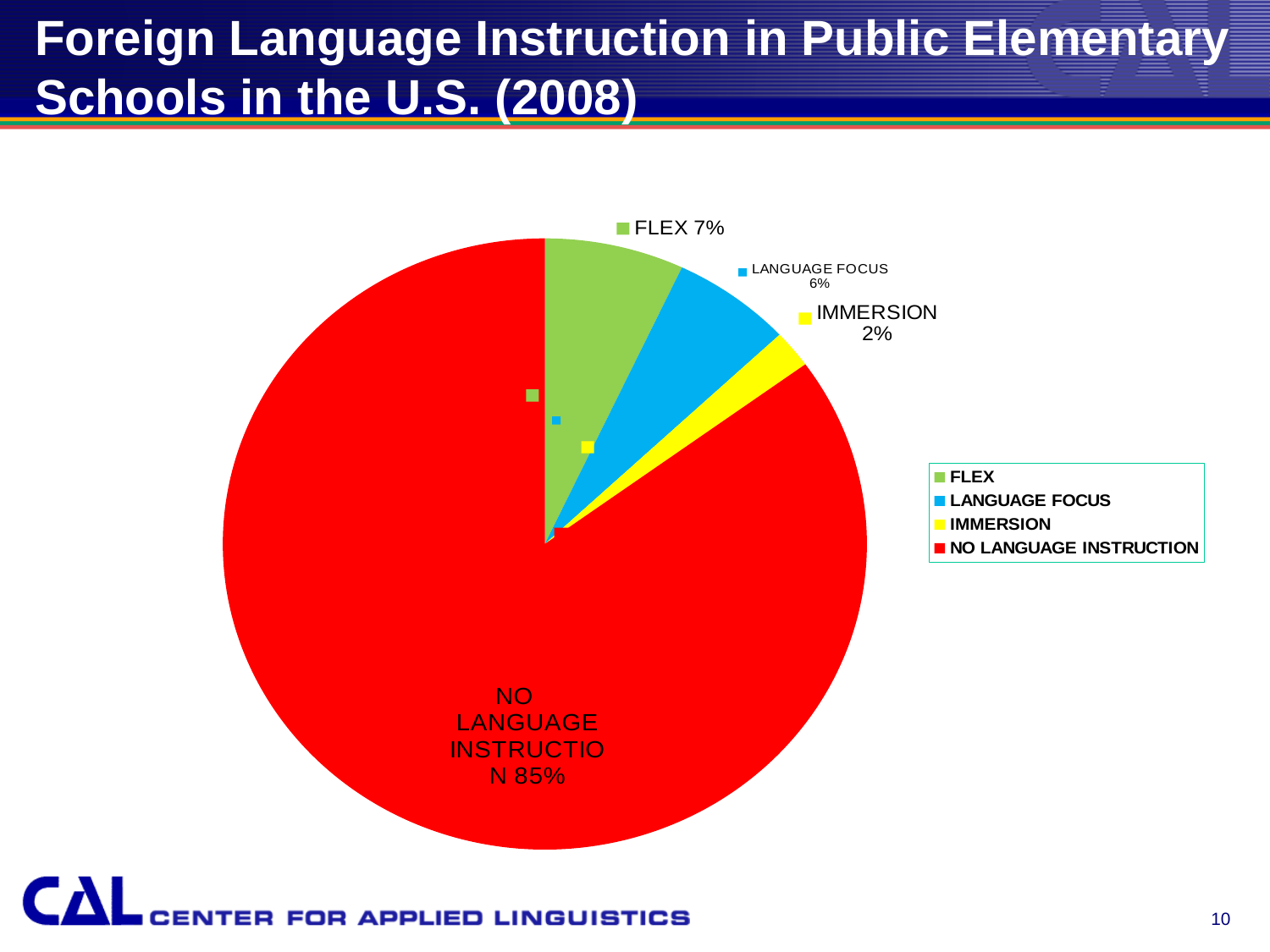
How many slices does the pie chart have? 4 What percentage of the pie is labelled NO LANGUAGE INSTRUCTION? 85% What percentage of the pie is labelled IMMERSION? 2% How many entries does the legend list? 4 What percentage of the pie is labelled FLEX? 7% What is the difference in percentage points between the NO LANGUAGE INSTRUCTION slice and the FLEX slice? 78 Which slice of the pie is the largest? NO LANGUAGE INSTRUCTION Which slice of the pie is the smallest? IMMERSION What colour is the NO LANGUAGE INSTRUCTION slice? red What percentage of the pie is labelled LANGUAGE FOCUS? 6% What kind of chart is shown on the slide? pie chart Which slice is larger, FLEX or IMMERSION? FLEX